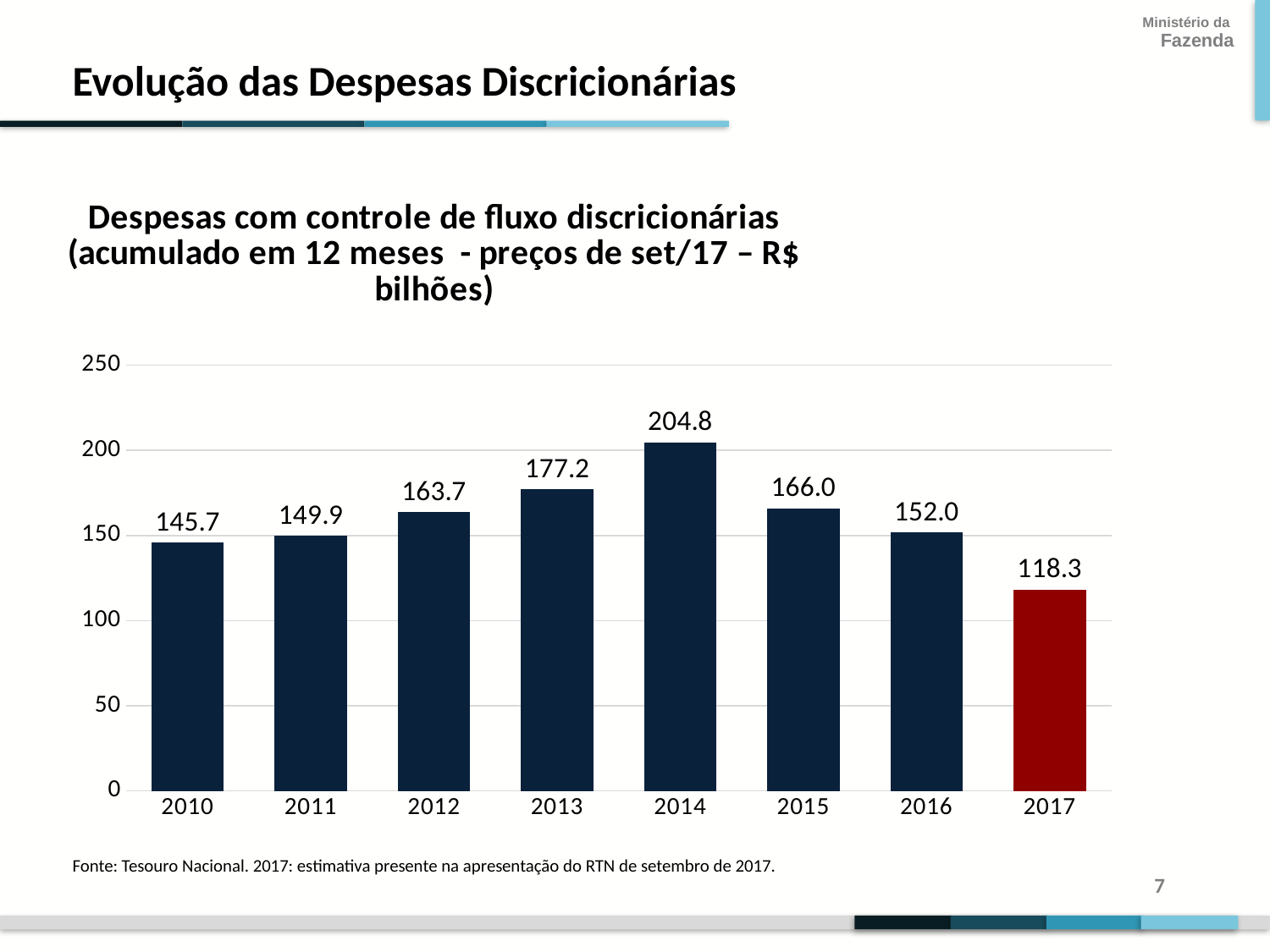
How many years are shown on the x axis? 8 Which bar is shown in a different colour (red) from the others? 2017 What is the value for 2014? 204.8 Which year has the lowest value? 2017 What is the difference between the values for 2013 and 2012? 13.5 Which year has the highest value? 2014 What is the difference between the values for 2014 and 2017? 86.5 What kind of chart is shown on the slide? bar chart What is the value for 2010? 145.7 Is the value for 2014 greater or less than 200? greater Which is larger, the value for 2015 or the value for 2016? 2015 What is the value for 2017? 118.3